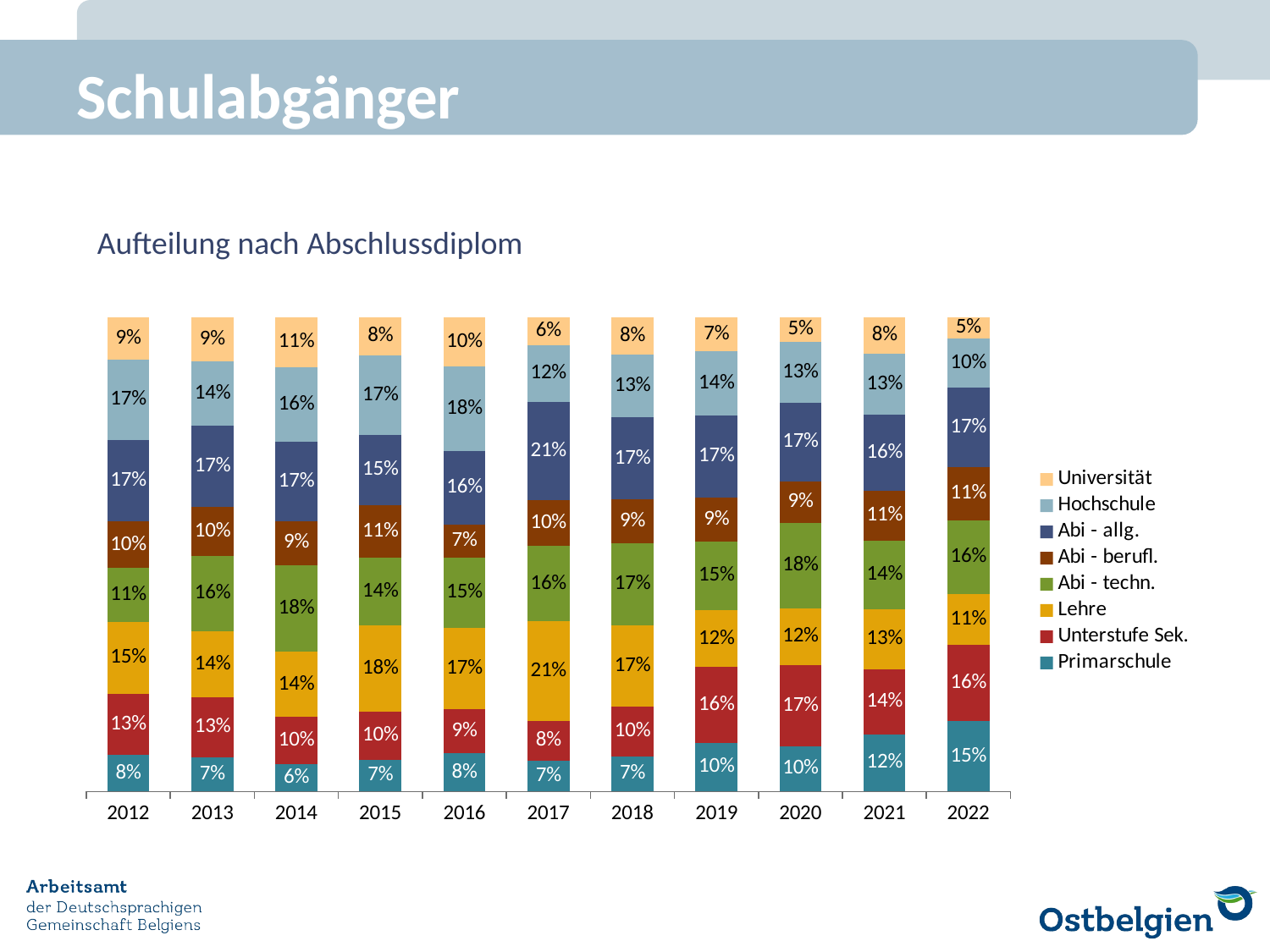
In which year is the Primarschule share the highest? 2022 What is the value for Universität in 2014? 11% In which year is the Primarschule share the lowest? 2014 What is the subtitle of the chart? Aufteilung nach Abschlussdiplom What is the difference between the Unterstufe Sek. value in 2020 and in 2017? 9 percentage points What kind of chart is shown on the slide? stacked bar chart How many years are shown on the x axis of the chart? 11 What is the value for Primarschule in 2022? 15% What is the value for Lehre in 2017? 21% Which is larger in 2019: Abi - techn. or Lehre? Abi - techn. What is the value for Hochschule in 2016? 18% How many series does the legend list? 8